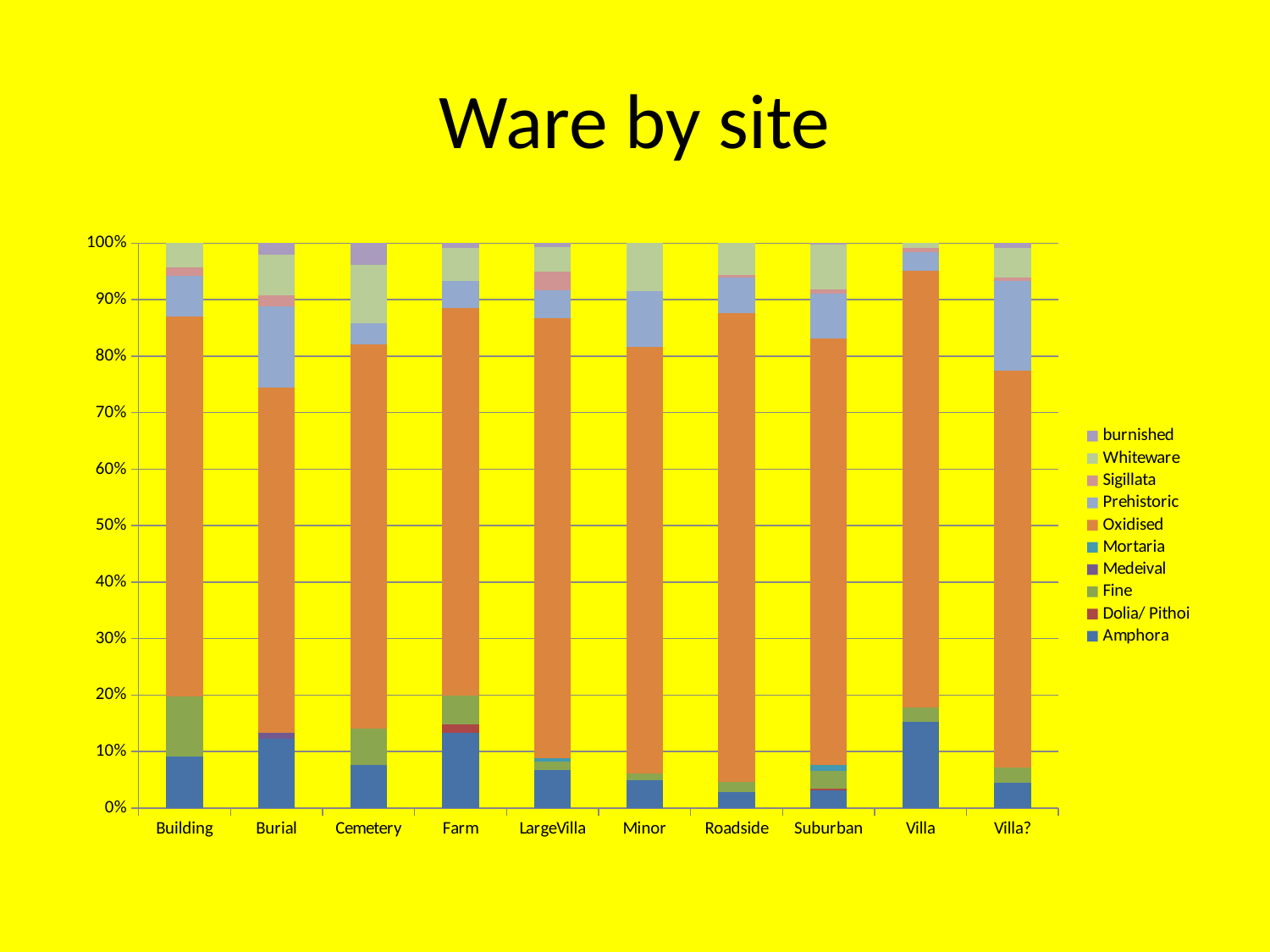
How many sites (categories) are shown along the x axis? 10 Which site has the largest Amphora share? Villa Is the Amphora value for Villa greater or less than 10%? greater Which has the larger Amphora share, Building or Minor? Building Which has the larger Amphora share, Villa or Roadside? Villa Is the Amphora value for Roadside greater or less than 10%? less How many series does the legend list? 10 What does each stacked bar total? 100% What kind of chart is shown on the slide? Stacked bar chart What is the title of the chart? Ware by site Which series forms the bottom segment of each bar? Amphora Is the Amphora value for Farm greater or less than 10%? greater